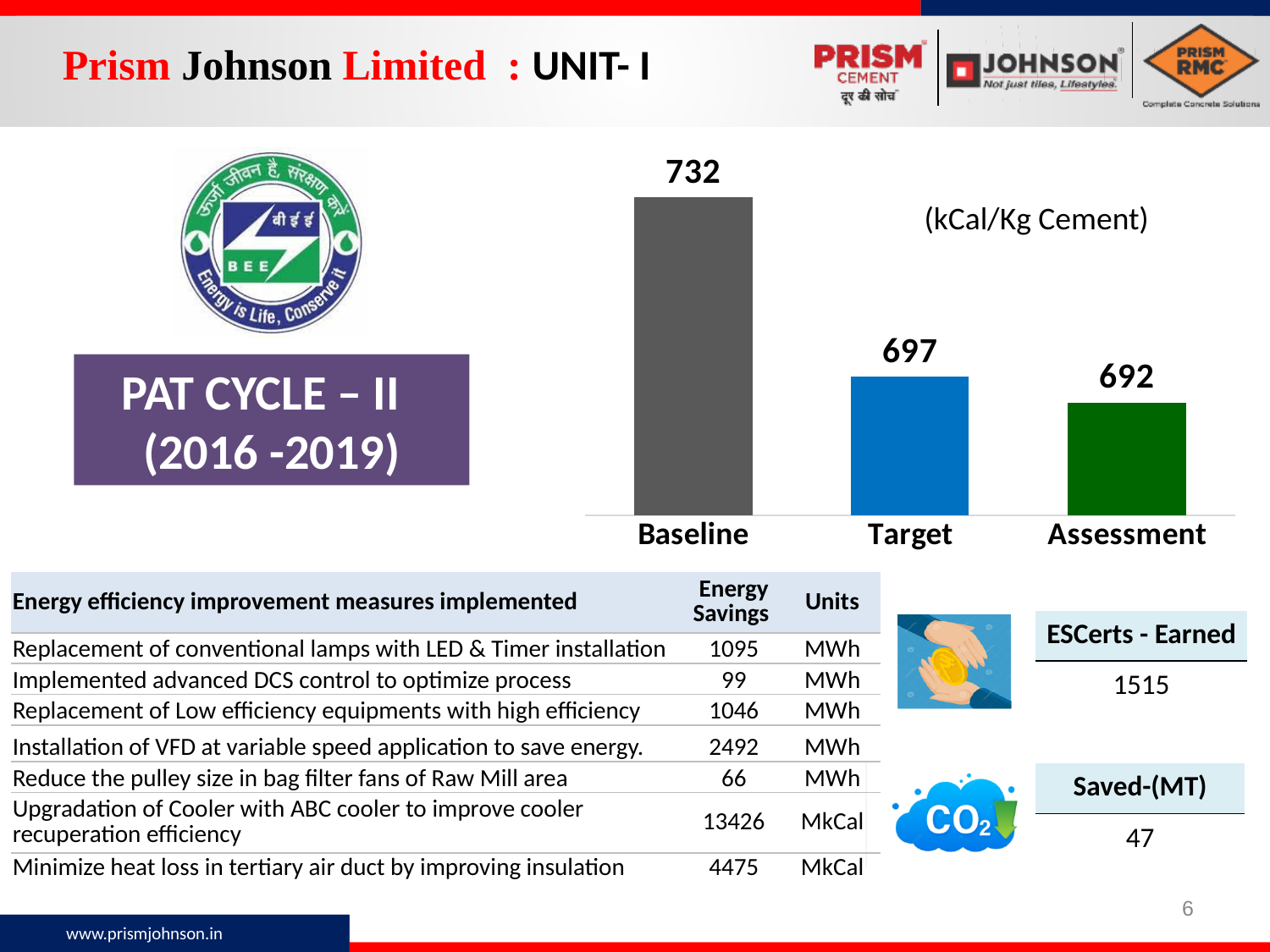
What is the difference between the Baseline and Target values? 35 Which category has the lowest value in the chart? Assessment What is the difference between the Baseline and Assessment values? 40 What is the difference between the Target and Assessment values? 5 What is the value for Target in the chart? 697 How many categories are shown in the chart? 3 Which is larger, the Baseline value or the Assessment value? Baseline What is the value for Baseline in the chart? 732 Which category has the highest value in the chart? Baseline What is the value for Assessment in the chart? 692 What kind of chart is shown on the slide? Bar chart What unit is shown next to the chart? kCal/Kg Cement